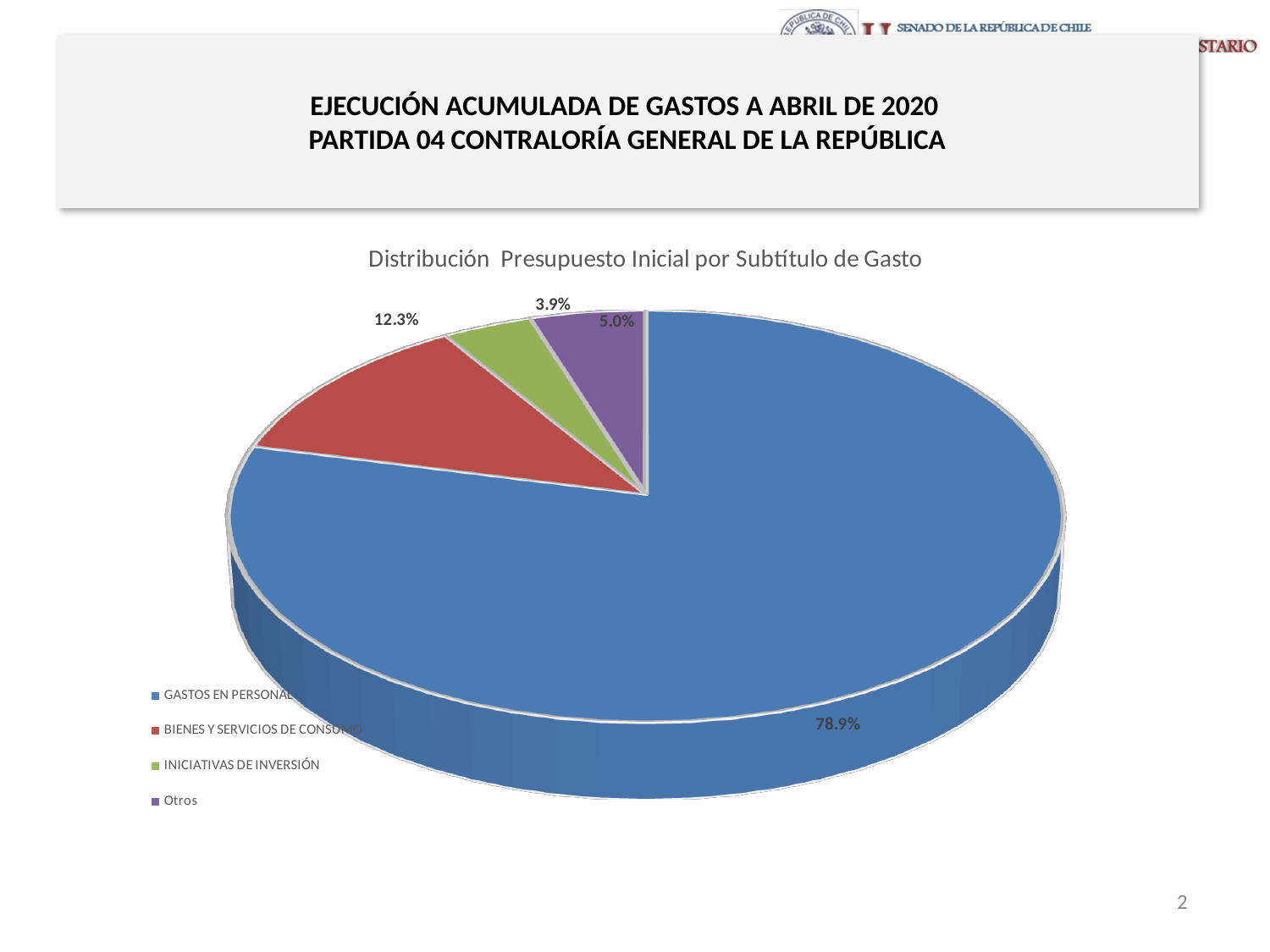
Which is larger, the share for Otros or the share for INICIATIVAS DE INVERSIÓN? Otros What type of chart is shown on the slide? Pie chart What share of the pie does Otros represent? 5.0% Which category has the smallest slice of the pie? INICIATIVAS DE INVERSIÓN Which category has the largest slice of the pie? GASTOS EN PERSONAL What is the title of the chart? Distribución Presupuesto Inicial por Subtítulo de Gasto What share of the pie does BIENES Y SERVICIOS DE CONSUMO represent? 12.3% What colour is the slice for BIENES Y SERVICIOS DE CONSUMO? Red What is the difference in percentage points between GASTOS EN PERSONAL and BIENES Y SERVICIOS DE CONSUMO? 66.6 How many categories does the pie chart show? 4 What share of the pie does GASTOS EN PERSONAL represent? 78.9%